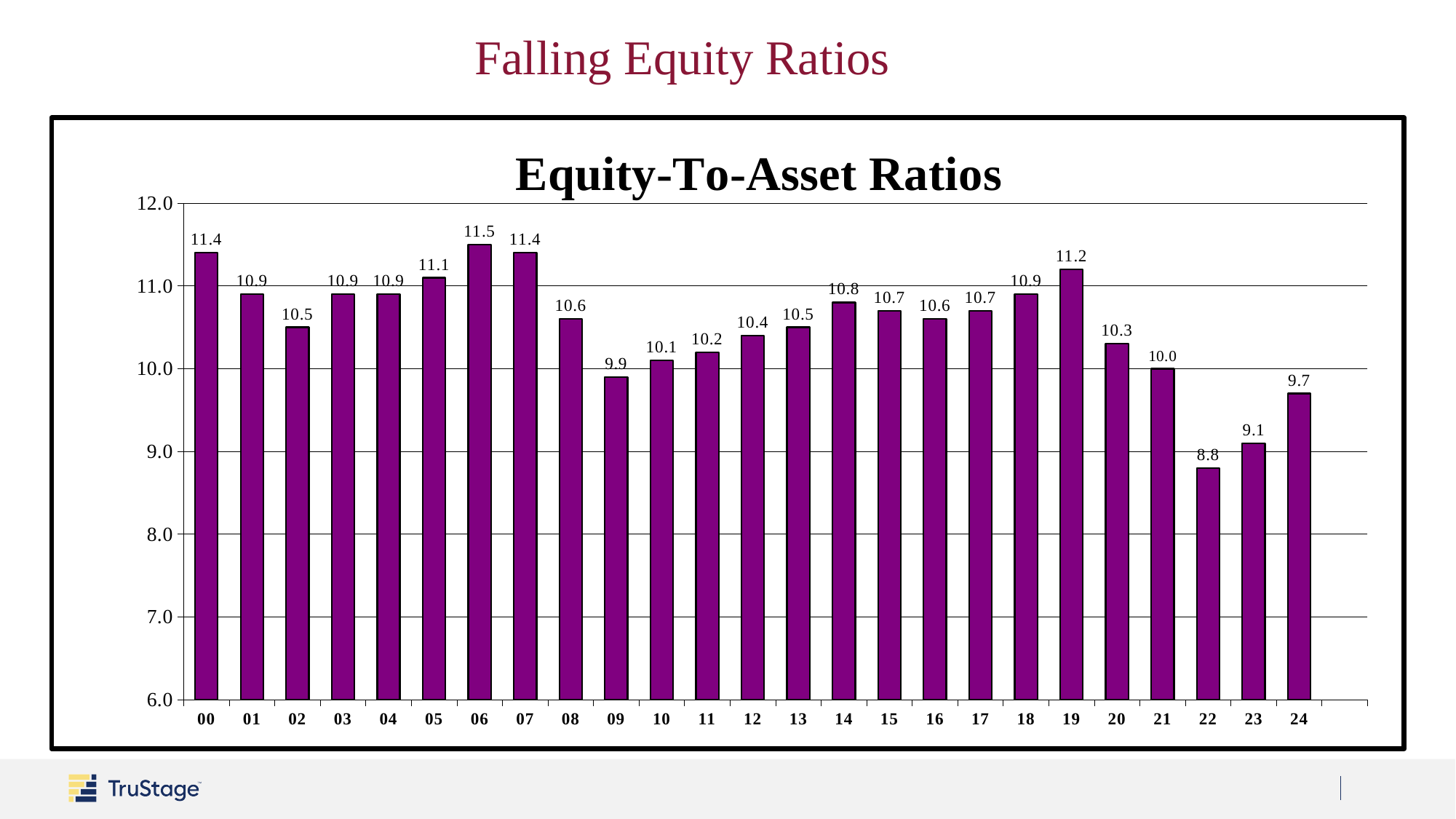
Which year has a higher equity-to-asset ratio, 19 or 20? 19 Do the equity-to-asset ratios generally rise or fall from 19 to 22? Fall How many years are shown on the x axis of the chart? 25 What is the title of the chart? Equity-To-Asset Ratios Which year has the highest equity-to-asset ratio? 06 What kind of chart is shown on the slide? Bar chart What is the difference between the equity-to-asset ratio for 06 and for 22? 2.7 Which year has the lowest equity-to-asset ratio? 22 What is the equity-to-asset ratio for 24? 9.7 What is the equity-to-asset ratio for 06? 11.5 Is the equity-to-asset ratio for 23 greater or less than 10.0? less What is the equity-to-asset ratio for 22? 8.8